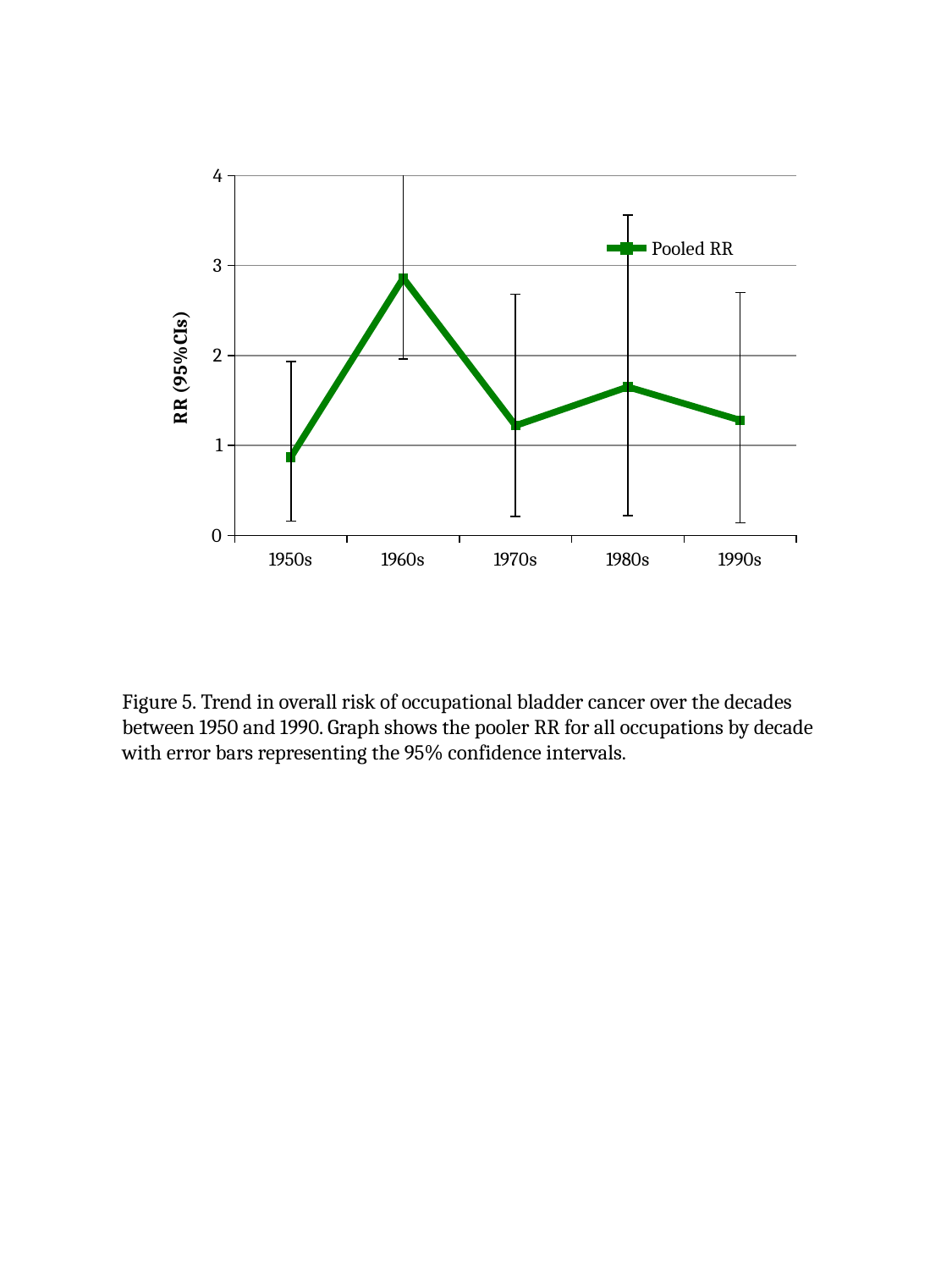
How many series does the legend list? 1 What kind of chart is shown on the slide? line chart Does the pooled RR rise or fall from the 1950s to the 1960s? rise Which decade has the lowest pooled RR? 1950s Which has a larger pooled RR, the 1960s or the 1980s? 1960s Is the pooled RR for the 1960s greater or less than 2? greater Which has a larger pooled RR, the 1980s or the 1990s? 1980s What is the label of the y axis? RR (95% CIs) Is the pooled RR for the 1950s greater or less than 1? less Which decade has the highest pooled RR? 1960s How many decades are plotted on the x axis? 5 Is the pooled RR for the 1980s greater or less than 2? less